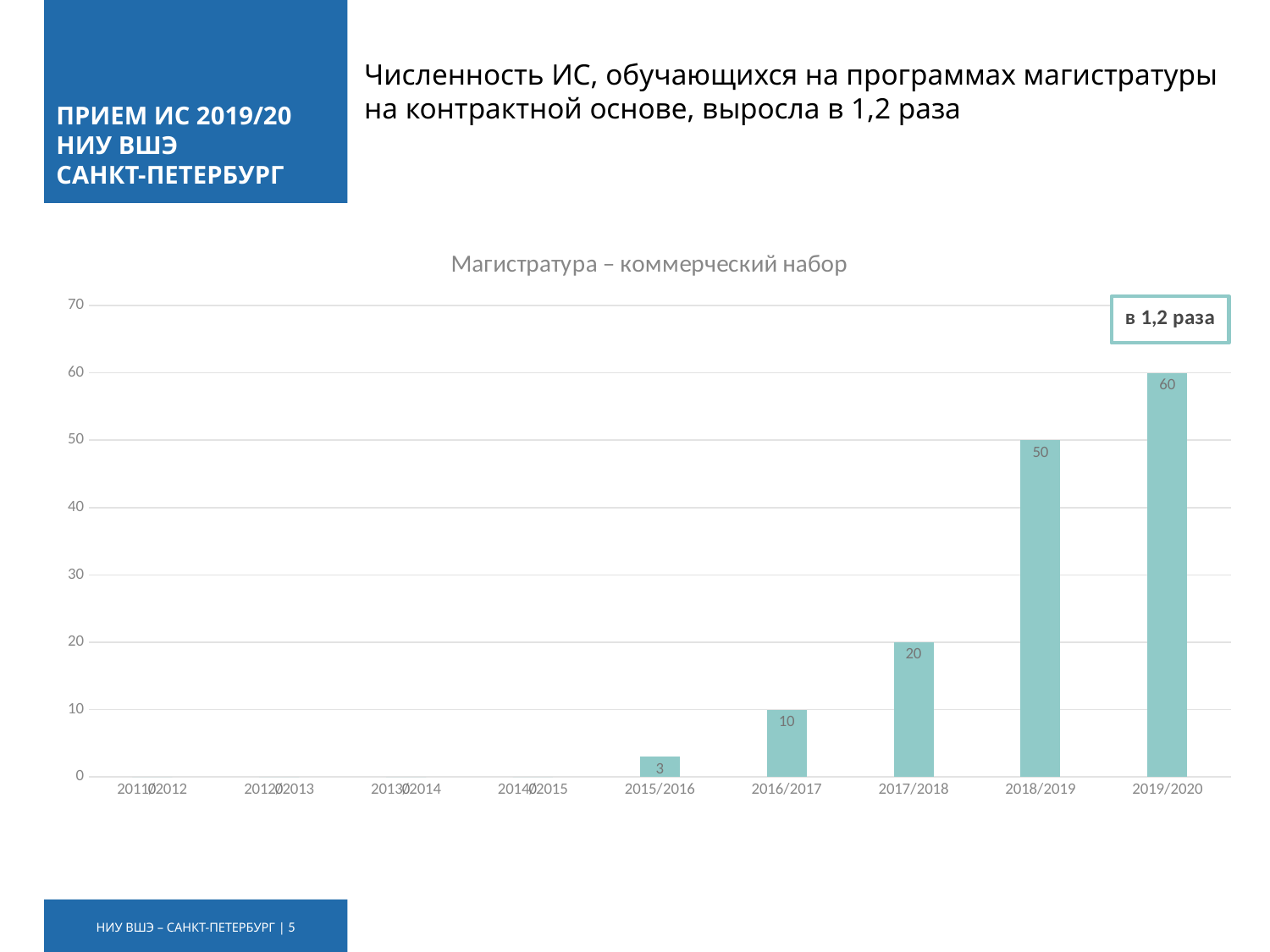
What kind of chart is shown on the slide? Bar chart What is the difference between the values for 2018/2019 and 2017/2018? 30 What is the value for 2016/2017 in the chart? 10 Which year has the highest value in the chart? 2019/2020 What is the value for 2018/2019 in the chart? 50 Do the values rise or fall from 2015/2016 to 2019/2020? Rise What is the title of the chart? Магистратура – коммерческий набор Among the bars shown with data labels, which year has the lowest value? 2015/2016 What is the value for 2015/2016 in the chart? 3 Which is larger, the value for 2017/2018 or the value for 2016/2017? 2017/2018 What is the value for 2019/2020 in the chart? 60 What is the difference between the values for 2019/2020 and 2018/2019? 10